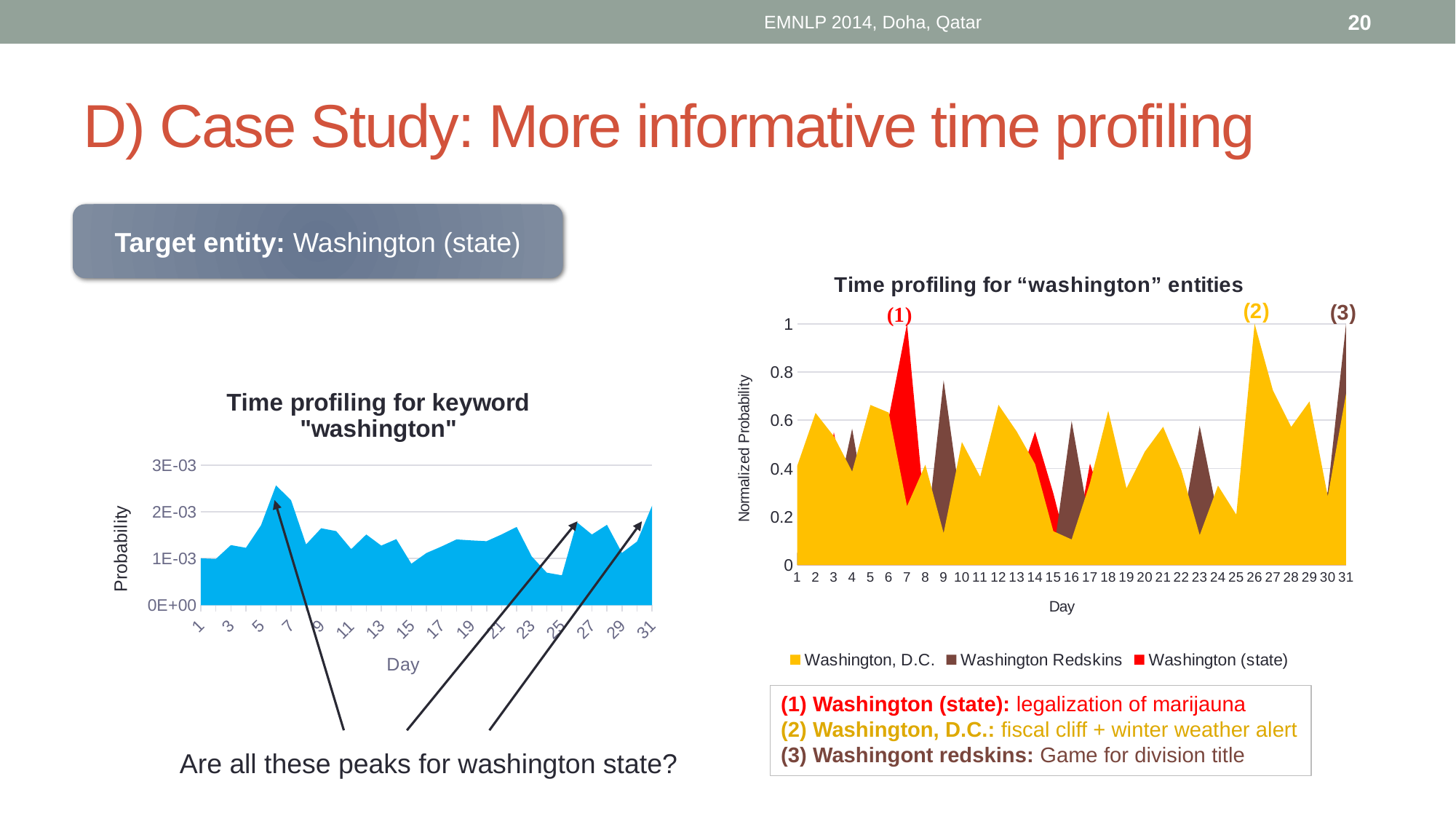
In the "Time profiling for keyword "washington"" chart, is the value on day 6 greater or less than 2E-03? greater In the "Time profiling for "washington" entities" chart, which series peaks on day 31? Washington Redskins What kind of chart is the "Time profiling for keyword "washington"" chart on the left? area chart In the "Time profiling for "washington" entities" chart, which series has the higher value on day 9: Washington Redskins or Washington, D.C.? Washington Redskins How many series does the legend of the "Time profiling for "washington" entities" chart list? 3 What is the y-axis title of the "Time profiling for "washington" entities" chart? Normalized Probability In the "Time profiling for keyword "washington"" chart, is the value on day 25 greater or less than 1E-03? less How many days are plotted along the x axis of the "Time profiling for "washington" entities" chart? 31 In the "Time profiling for "washington" entities" chart, on which day does Washington (state) reach its peak value of 1? 7 In the "Time profiling for keyword "washington"" chart, on which day does the probability reach its highest value? 6 In the "Time profiling for "washington" entities" chart, is the value for Washington, D.C. on day 26 greater or less than 0.8? greater In the "Time profiling for "washington" entities" chart, which series is shown in yellow? Washington, D.C.